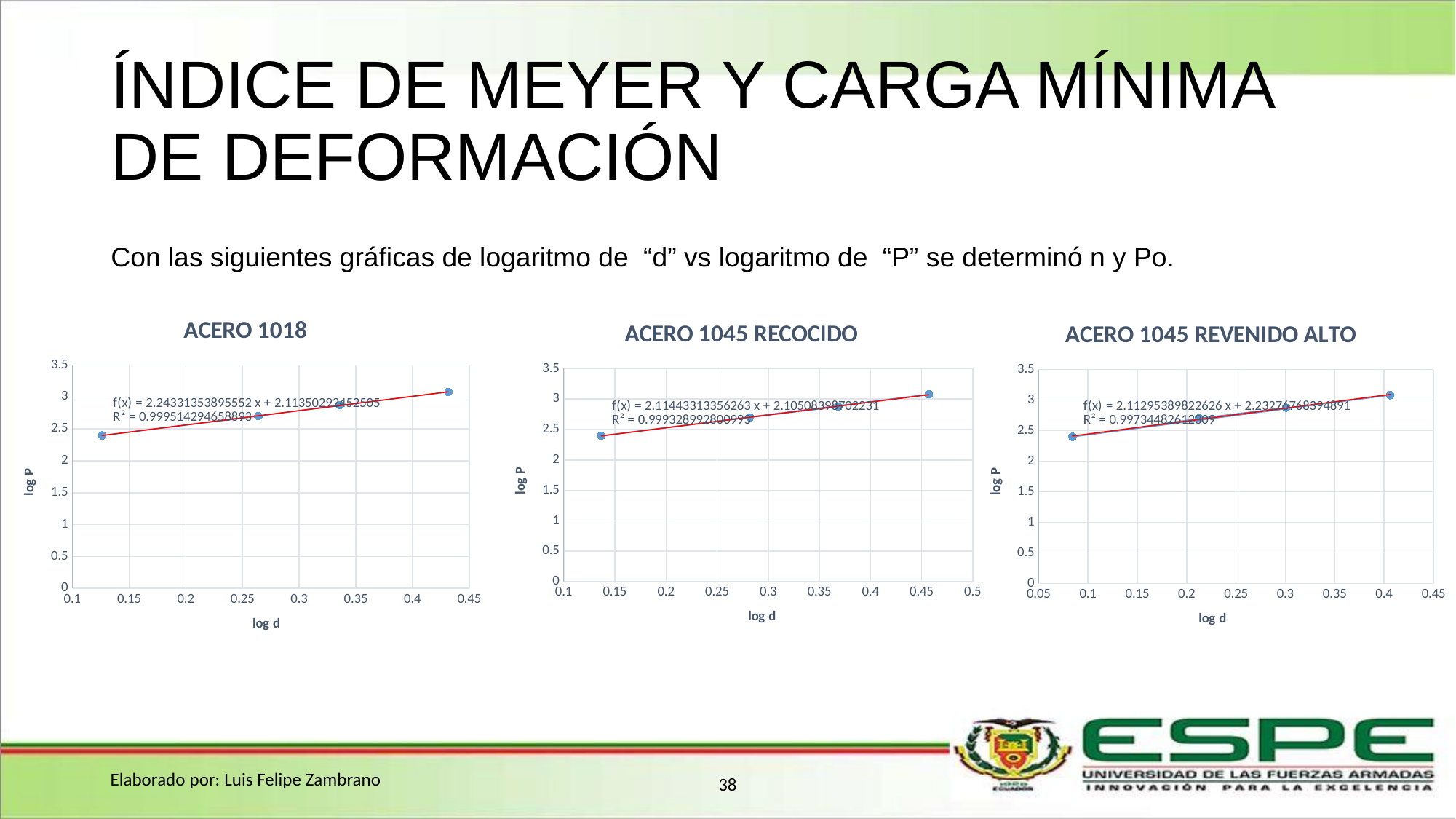
What is the label of the y axis on the ACERO 1045 REVENIDO ALTO chart? log P How many charts are shown on the slide? 3 On the ACERO 1045 RECOCIDO chart, is the log P value of the leftmost point greater or less than 2? greater On the ACERO 1045 REVENIDO ALTO chart, do the values of log P rise or fall as log d increases? Rise How many data points are plotted on the ACERO 1045 RECOCIDO chart? 4 What is the slope of the trendline equation shown on the ACERO 1045 RECOCIDO chart? 2.11443313356263 What is the slope of the trendline equation shown on the ACERO 1018 chart? 2.24331353895552 On the ACERO 1018 chart, is the log P value of the rightmost point greater or less than 2.5? greater How many data points are plotted on the ACERO 1018 chart? 4 On the ACERO 1018 chart, do the plotted values rise or fall along the x axis? Rise What is the slope of the trendline equation shown on the ACERO 1045 REVENIDO ALTO chart? 2.11295389822626 What kind of chart is the ACERO 1018 chart? Scatter chart